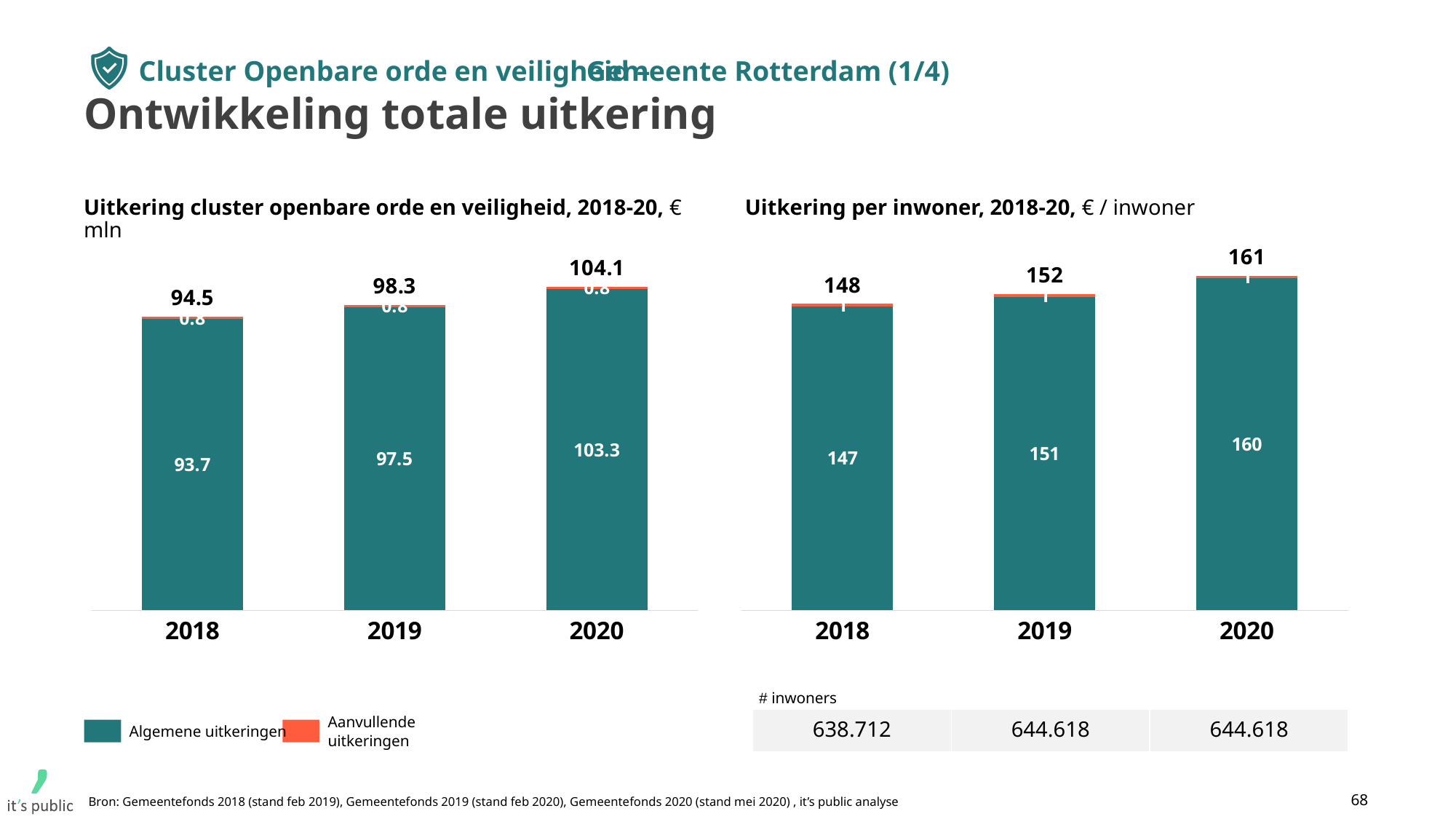
In the right chart, which year has the lowest uitkering per inwoner? 2018 In the right chart, what is the difference between the total for 2020 and the total for 2019? 9 In the right chart, what is the value of Algemene uitkeringen for 2020? 160 In the left chart, what is the value of Algemene uitkeringen for 2019? 97.5 How many series does the legend list? 2 In the left chart (Uitkering cluster openbare orde en veiligheid), what is the total value shown for 2020? 104.1 In the left chart, do the total values rise or fall from 2018 to 2020? rise In the left chart, what is the difference between the total for 2020 and the total for 2018? 9.6 In the left chart, which year has the highest total uitkering? 2020 In the right chart (Uitkering per inwoner), what is the total value shown for 2019? 152 What kind of chart is the left chart? stacked bar chart In the left chart, what is the value of Aanvullende uitkeringen for 2018? 0.8